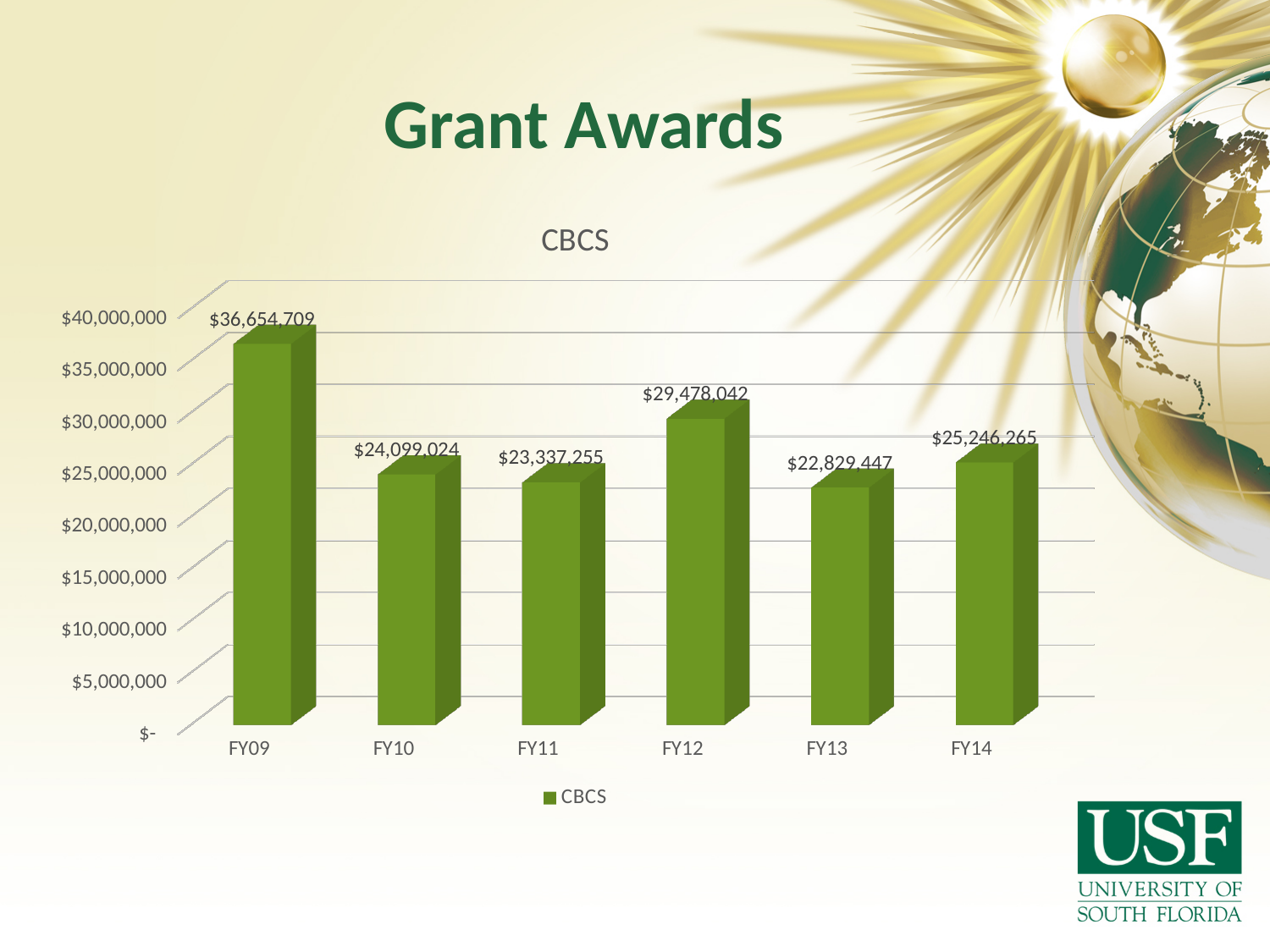
What type of chart is shown on the slide? Bar chart What is the grant award value for FY09? $36,654,709 How many fiscal years are shown on the chart? 6 What is the grant award value for FY14? $25,246,265 Which fiscal year has the lowest grant award value? FY13 Is the grant award value for FY12 greater or less than $25,000,000? greater Which fiscal year has the highest grant award value? FY09 What is the grant award value for FY12? $29,478,042 Which is larger, the grant award value for FY10 or for FY14? FY14 What is the difference between the FY09 and FY10 grant award values? $12,555,685 What is the title of the chart? CBCS What is the difference between the FY12 and FY13 grant award values? $6,648,595